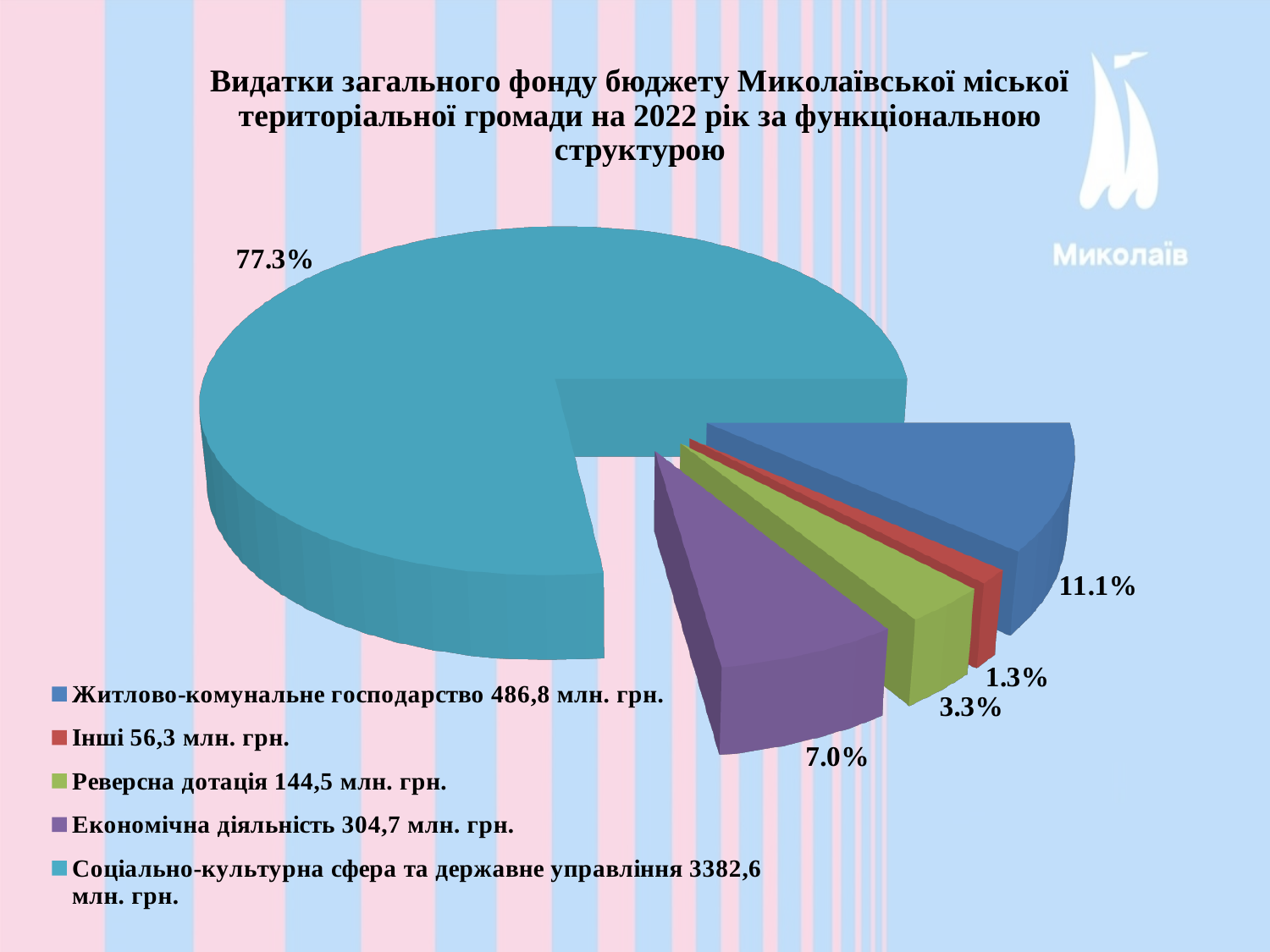
Which category has the smallest share of the pie? Інші What is the difference in percentage points between the share for Житлово-комунальне господарство and the share for Економічна діяльність? 4.1% What share of the pie does Економічна діяльність represent? 7.0% Which category has the largest share of the pie? Соціально-культурна сфера та державне управління What kind of chart is shown on the slide? pie chart What amount in млн. грн. is shown in the legend for Економічна діяльність? 304,7 млн. грн. How many slices does the pie chart have? 5 What share of the pie does Житлово-комунальне господарство represent? 11.1% What share of the pie does Реверсна дотація represent? 3.3% Which is larger: the share for Реверсна дотація or the share for Інші? Реверсна дотація What colour is the slice for Інші? red